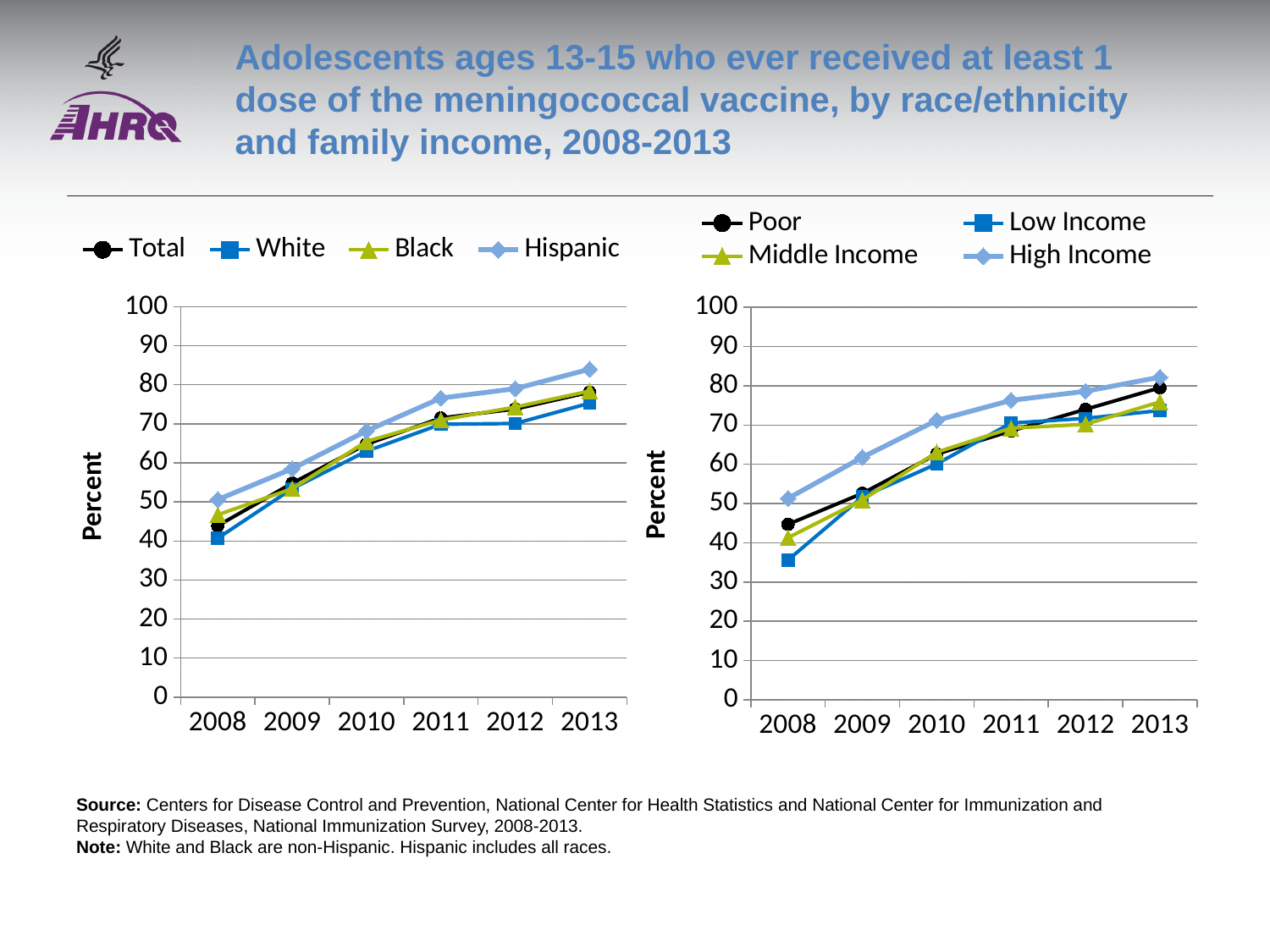
In the left chart (by race/ethnicity), which is larger in 2008: the value for Hispanic or the value for Total? Hispanic In the right chart (by family income), does the Poor series rise or fall from 2008 to 2013? rise In the right chart (by family income), which group has the highest value in 2013? High Income In the left chart (by race/ethnicity), which group has the lowest value in 2008? White In the left chart (by race/ethnicity), is the value for Hispanic in 2013 greater or less than 80? greater In the left chart (by race/ethnicity), which group has the highest value in 2013? Hispanic How many years are shown on the x axis of the left chart (by race/ethnicity)? 6 How many series does the legend of the right chart (by family income) list? 4 In the left chart (by race/ethnicity), is the value for White in 2008 greater or less than 50? less What kind of chart is the left chart (by race/ethnicity)? line chart In the right chart (by family income), which group has the lowest value in 2008? Low Income In the right chart (by family income), is the value for Low Income in 2008 greater or less than 40? less